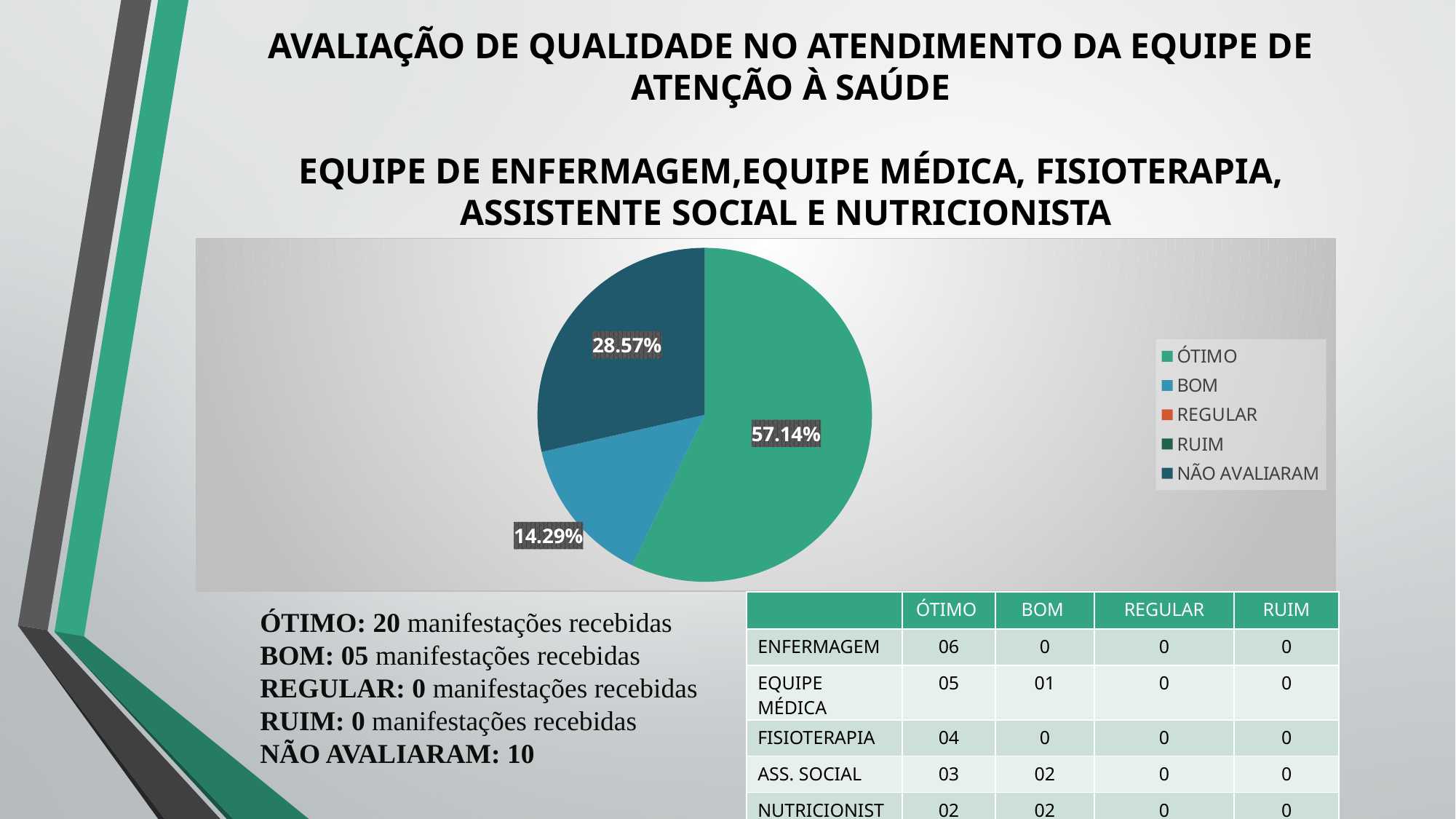
What is the difference in percentage points between the ÓTIMO slice and the NÃO AVALIARAM slice? 28.57% What kind of chart is shown on the slide? Pie chart What percentage of the pie chart is labelled for ÓTIMO? 57.14% How many slices are visible in the pie chart? 3 How many entries does the legend of the pie chart list? 5 What is the difference in percentage points between the NÃO AVALIARAM slice and the BOM slice? 14.28% Of the slices visible in the pie chart, which category has the smallest slice? BOM Which category has the largest slice in the pie chart? ÓTIMO Which slice is larger in the pie chart, BOM or NÃO AVALIARAM? NÃO AVALIARAM What percentage of the pie chart is labelled for BOM? 14.29% What percentage of the pie chart is labelled for NÃO AVALIARAM? 28.57% What colour is the ÓTIMO slice in the pie chart? Green